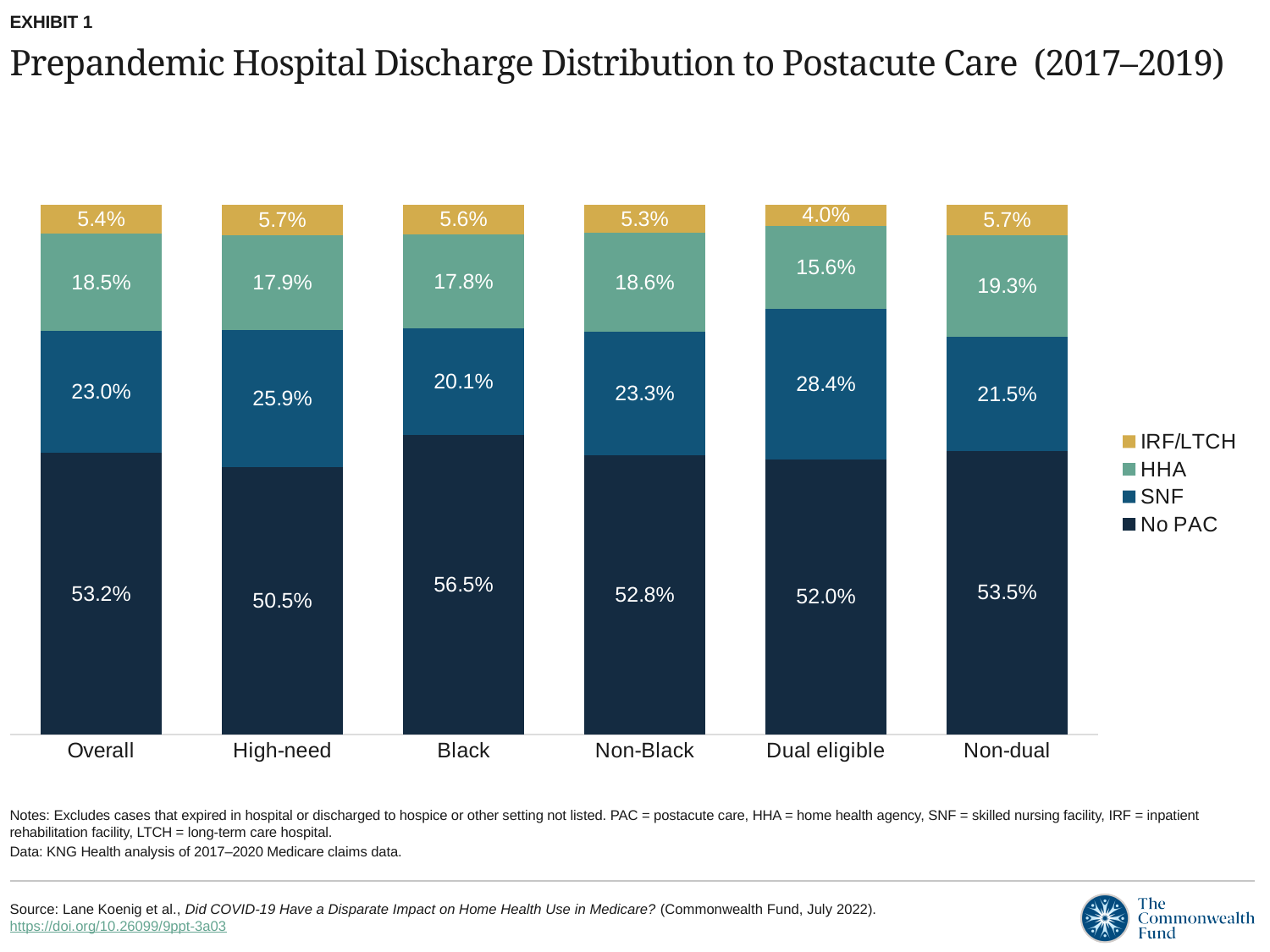
Which category has the lowest No PAC value? High-need Which category has the highest SNF value? Dual eligible How many series does the legend list? 4 What is the No PAC value for the Black category? 56.5% Which category has the lowest IRF/LTCH value? Dual eligible What is the difference between the SNF values for High-need and Black? 5.8 percentage points What kind of chart is shown on the slide? Stacked bar chart What is the HHA value for the Non-dual category? 19.3% What is the IRF/LTCH value for the Overall category? 5.4% What is the SNF value for the Dual eligible category? 28.4% How many categories are shown on the x axis? 6 Which is larger, the HHA value for Non-Black or the HHA value for Dual eligible? Non-Black